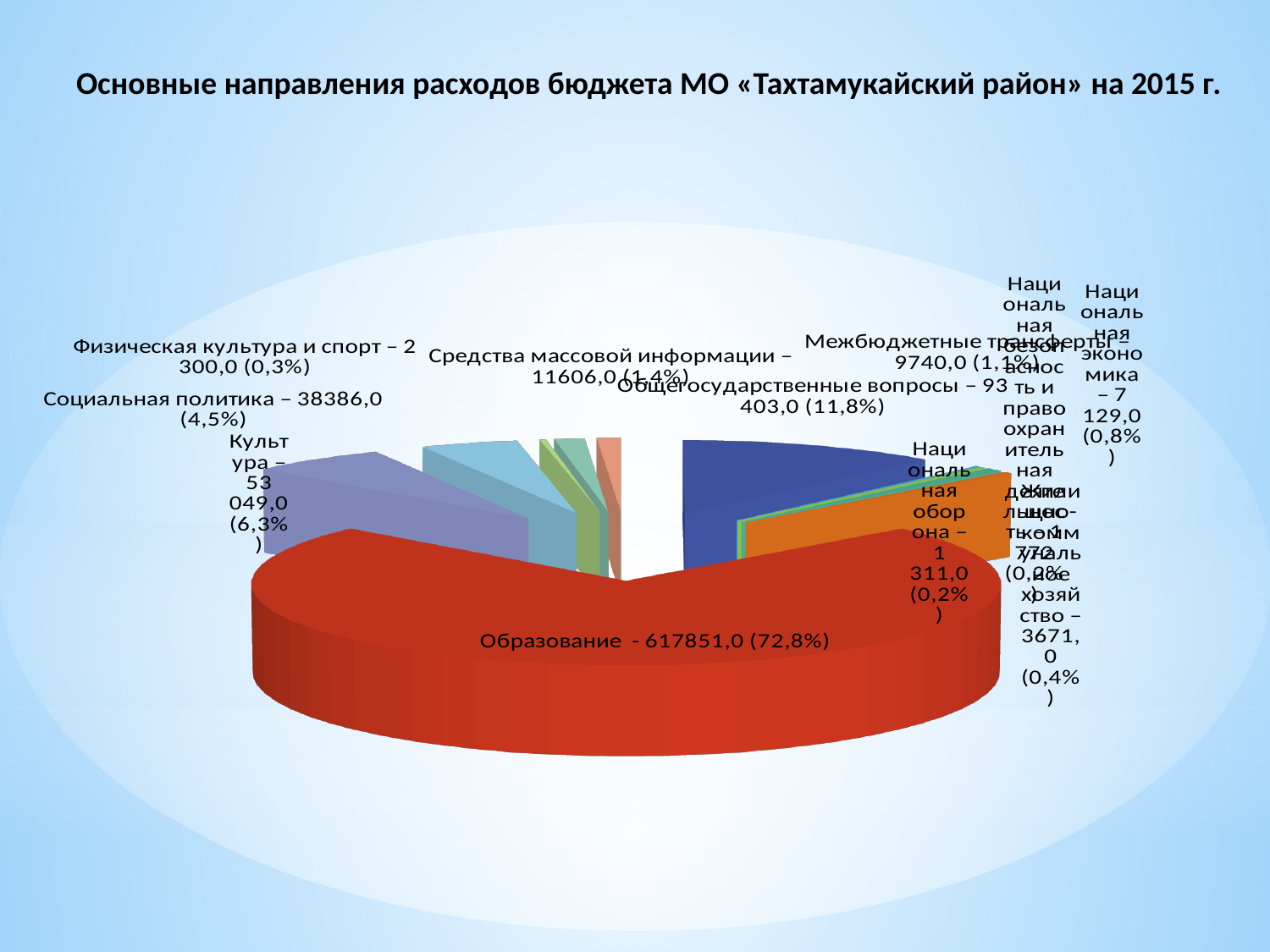
What value is shown for Общегосударственные вопросы? 93 403,0 What is the title of the chart? Основные направления расходов бюджета МО «Тахтамукайский район» на 2015 г. Which category has the largest slice of the pie? Образование What is the difference between the values for Общегосударственные вопросы and Культура? 40 354,0 What share of the pie does Образование take? 72,8% What value is shown for Социальная политика? 38386,0 What share of the pie does Средства массовой информации take? 1,4% What share of the pie does Национальная экономика take? 0,8% Which is larger, Межбюджетные трансферты or Физическая культура и спорт? Межбюджетные трансферты What kind of chart is shown on the slide? pie chart What value is shown for Образование? 617851,0